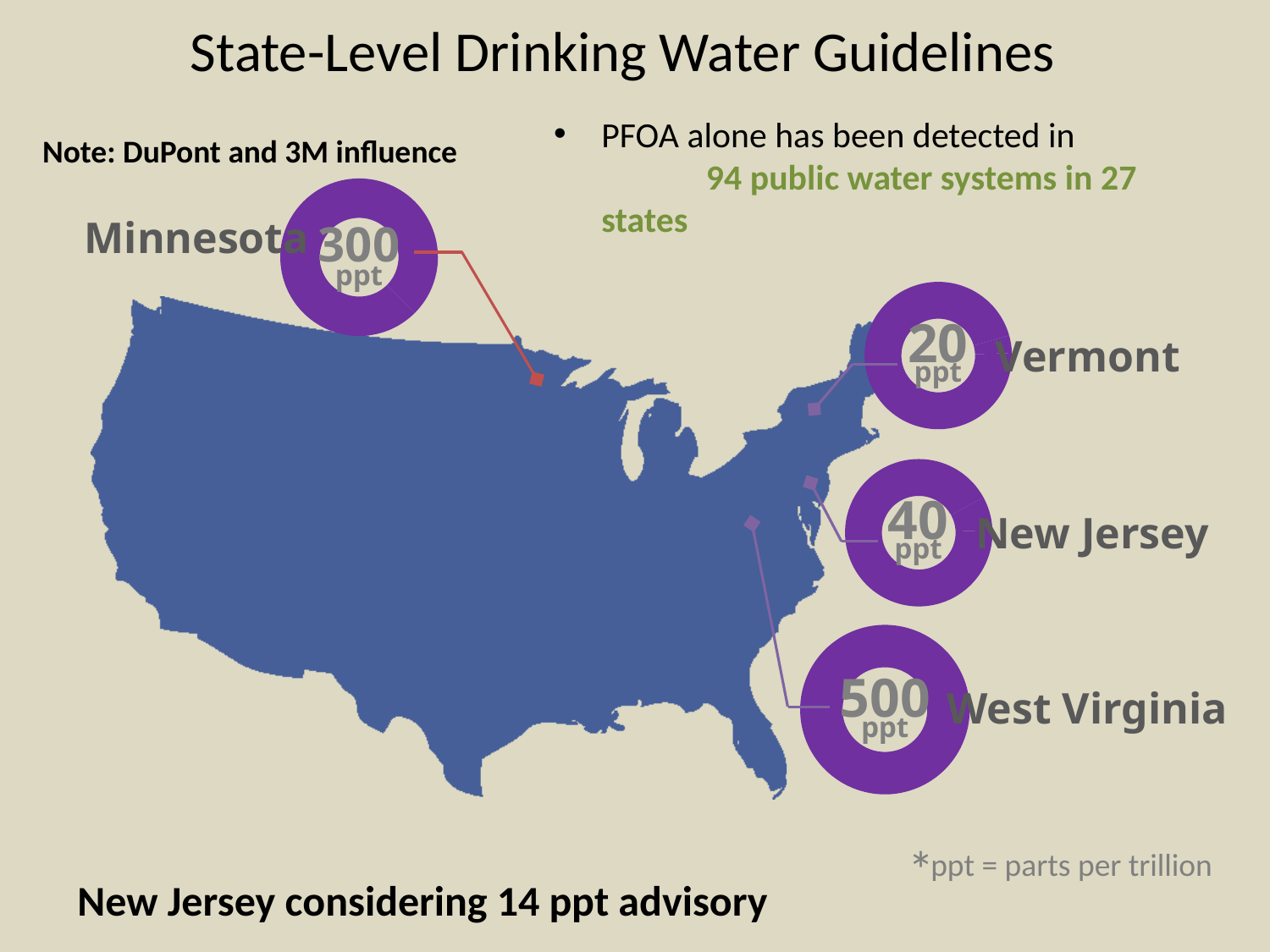
What is the difference between the New Jersey and Vermont guideline values? 20 ppt Which state has the highest guideline value shown on the map? West Virginia What is the drinking water guideline value shown for New Jersey? 40 ppt Which has a larger guideline value, Minnesota or New Jersey? Minnesota What kind of visualization is shown on the slide? A map with data callouts What is the drinking water guideline value shown for Minnesota? 300 ppt What is the drinking water guideline value shown for West Virginia? 500 ppt What is the drinking water guideline value shown for Vermont? 20 ppt What is the title of the slide? State-Level Drinking Water Guidelines Which state has the lowest guideline value shown on the map? Vermont What is the difference between the West Virginia and Minnesota guideline values? 200 ppt How many states have guideline values called out on the map? 4